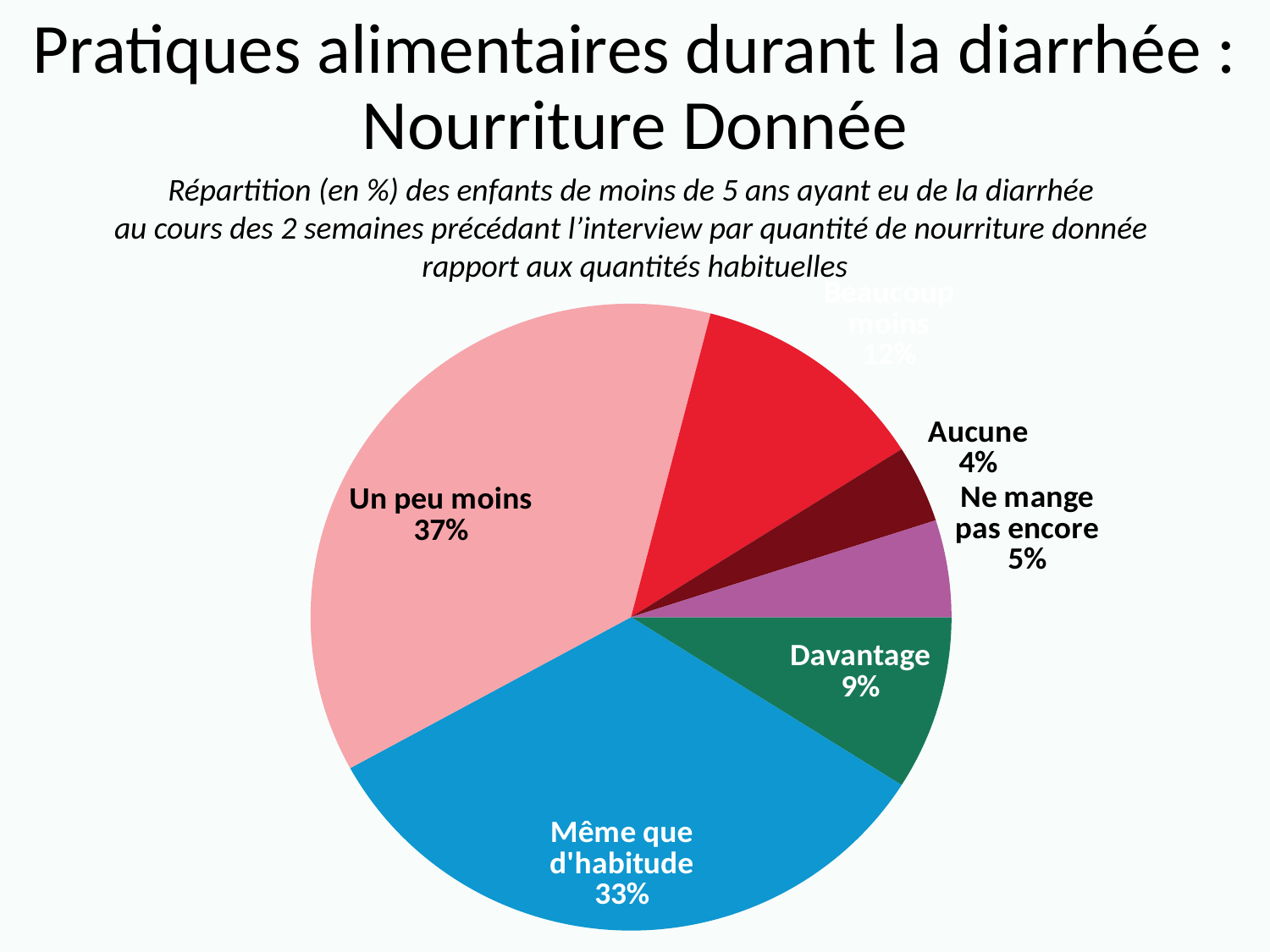
What percentage is shown for 'Ne mange pas encore'? 5% Which is larger, the share for 'Davantage' or the share for 'Ne mange pas encore'? Davantage Which category has the largest share of the pie? Un peu moins What kind of chart is shown on the slide? pie chart How many slices does the pie chart have? 6 What percentage is shown for 'Aucune'? 4% What percentage is shown for 'Davantage'? 9% What percentage of children received 'Un peu moins' food? 37% What percentage is shown for 'Même que d'habitude'? 33% Which category has the smallest share of the pie? Aucune What is the difference in percentage points between 'Un peu moins' and 'Même que d'habitude'? 4 What colour is the 'Même que d'habitude' slice? blue